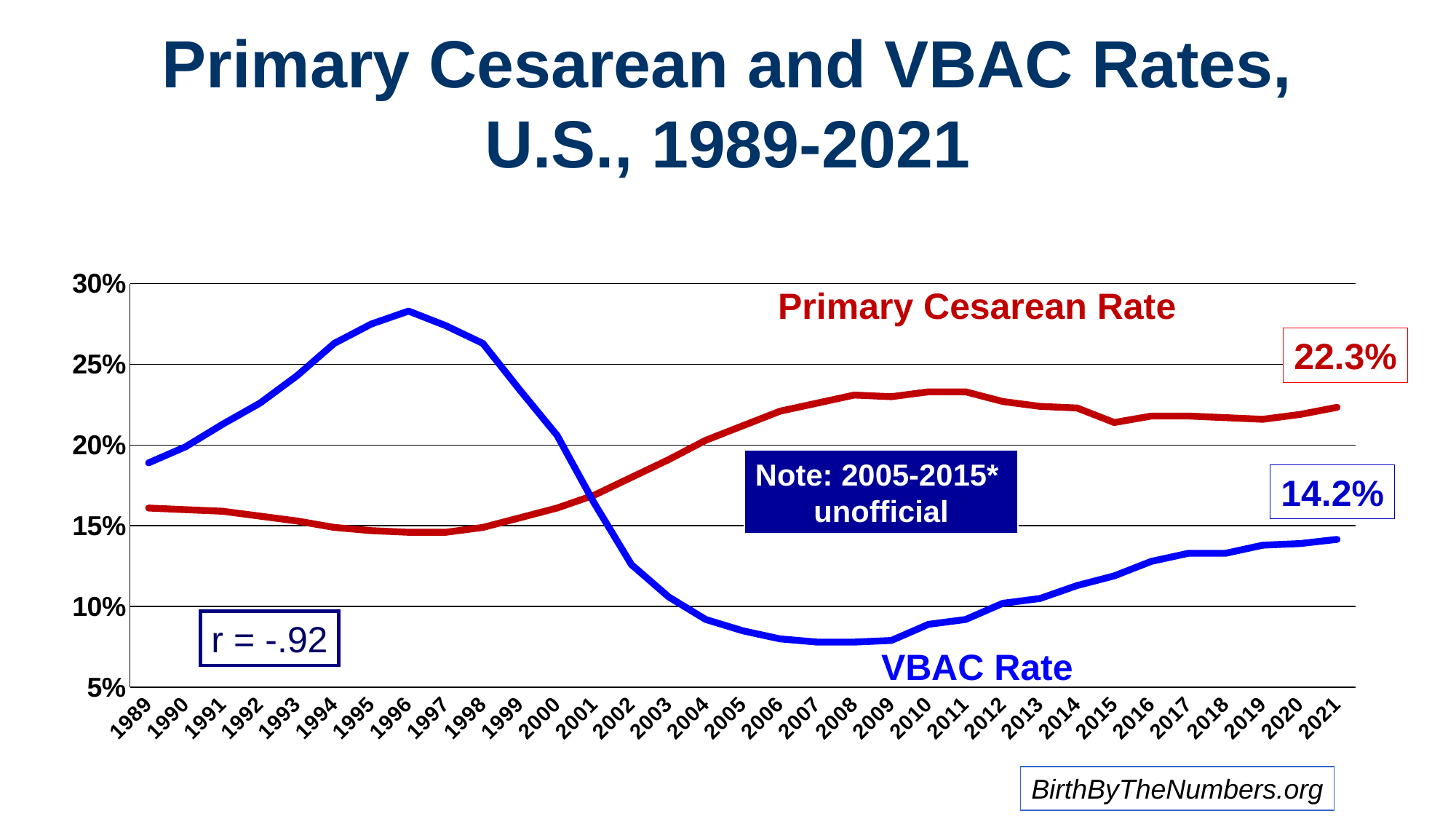
How many series are plotted on the chart? 2 What is the Primary Cesarean Rate in 2021? 22.3% Does the VBAC Rate rise or fall between 1996 and 2007? fall In 2021, which is higher: the Primary Cesarean Rate or the VBAC Rate? Primary Cesarean Rate What is the VBAC Rate in 2021? 14.2% What correlation coefficient (r) is shown on the chart? r = -.92 What is the difference between the Primary Cesarean Rate and the VBAC Rate in 2021? 8.1 percentage points In which year does the VBAC Rate reach its highest value? 1996 In 1996, which is higher: the Primary Cesarean Rate or the VBAC Rate? VBAC Rate What kind of chart is shown on the slide? line chart Is the VBAC Rate in 2007 greater or less than 10%? less Is the Primary Cesarean Rate in 2010 greater or less than 20%? greater